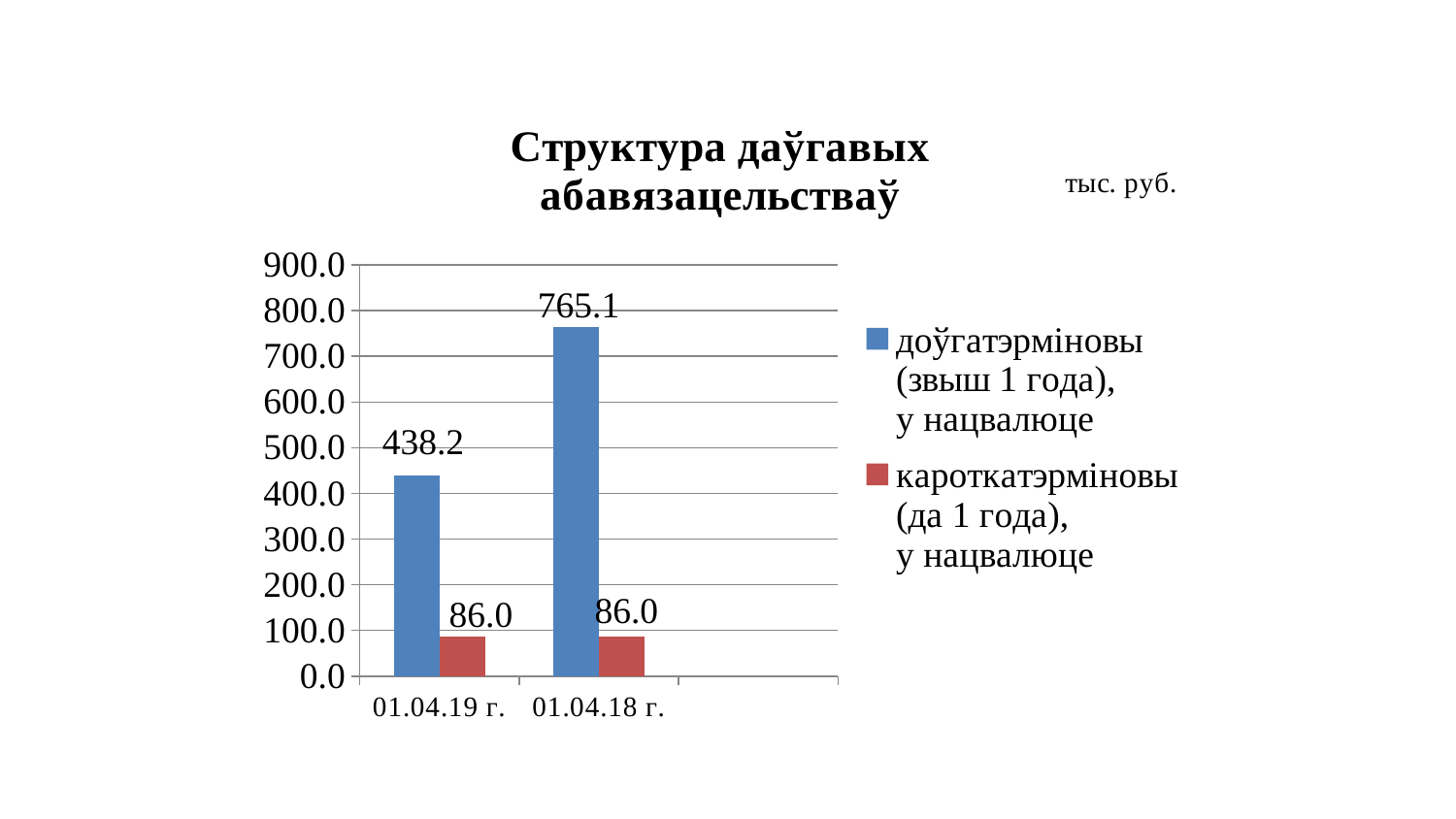
What kind of chart is shown on the slide? bar chart What is the value of the short-term (кароткатэрміновы) series for 01.04.19 г.? 86.0 What is the difference between the long-term values for 01.04.18 г. and 01.04.19 г.? 326.9 What is the value of the short-term (кароткатэрміновы) series for 01.04.18 г.? 86.0 What is the value of the long-term (доўгатэрміновы) series for 01.04.19 г.? 438.2 What unit is indicated next to the chart title? тыс. руб. Which is larger for 01.04.18 г.: the long-term value or the short-term value? long-term (доўгатэрміновы) What is the value of the long-term (доўгатэрміновы) series for 01.04.18 г.? 765.1 What is the difference between the long-term and short-term values for 01.04.19 г.? 352.2 Which date has the higher value for the long-term (доўгатэрміновы) series? 01.04.18 г. How many dates (categories) are shown on the x axis? 2 How many series does the legend list? 2